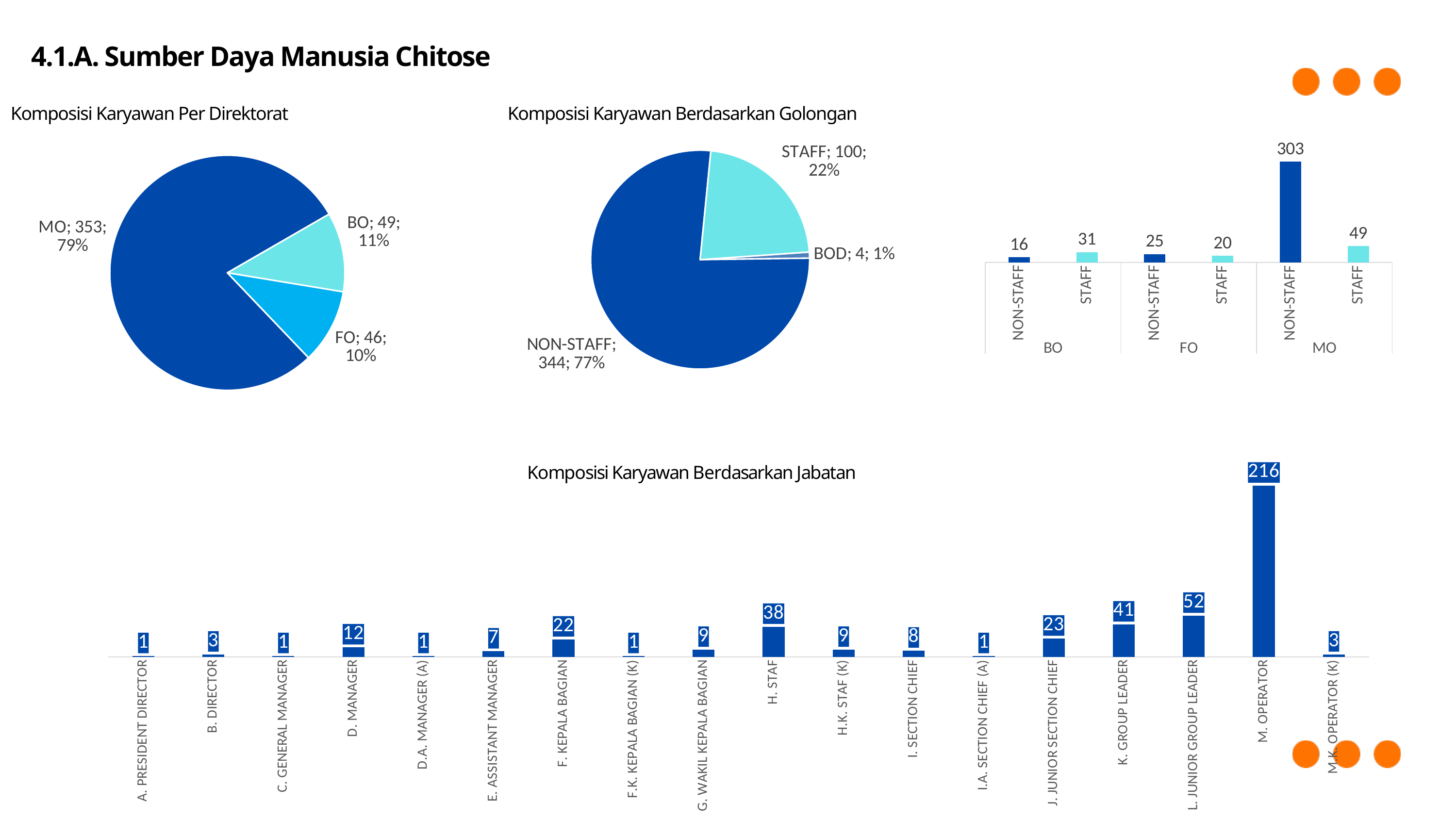
In the 'Komposisi Karyawan Berdasarkan Jabatan' chart, which category has the highest value? M. OPERATOR In the 'Komposisi Karyawan Berdasarkan Golongan' pie chart, what is the difference between NON-STAFF and STAFF? 244 In the 'Komposisi Karyawan Per Direktorat' pie chart, what share of the pie does BO have? 11% What kind of chart is 'Komposisi Karyawan Berdasarkan Jabatan'? Bar chart In the bar chart at the top right of the slide, which is larger under BO: NON-STAFF or STAFF? STAFF In the 'Komposisi Karyawan Berdasarkan Golongan' pie chart, what value is shown for STAFF? 100 In the 'Komposisi Karyawan Berdasarkan Golongan' pie chart, which category has the smallest slice? BOD In the bar chart at the top right of the slide, what is the value for NON-STAFF under MO? 303 In the bar chart at the top right of the slide, what is the difference between NON-STAFF and STAFF under FO? 5 How many categories are shown in the 'Komposisi Karyawan Berdasarkan Jabatan' chart? 18 In the 'Komposisi Karyawan Per Direktorat' pie chart, what value is shown for MO? 353 In the 'Komposisi Karyawan Berdasarkan Jabatan' chart, what is the value for L. JUNIOR GROUP LEADER? 52